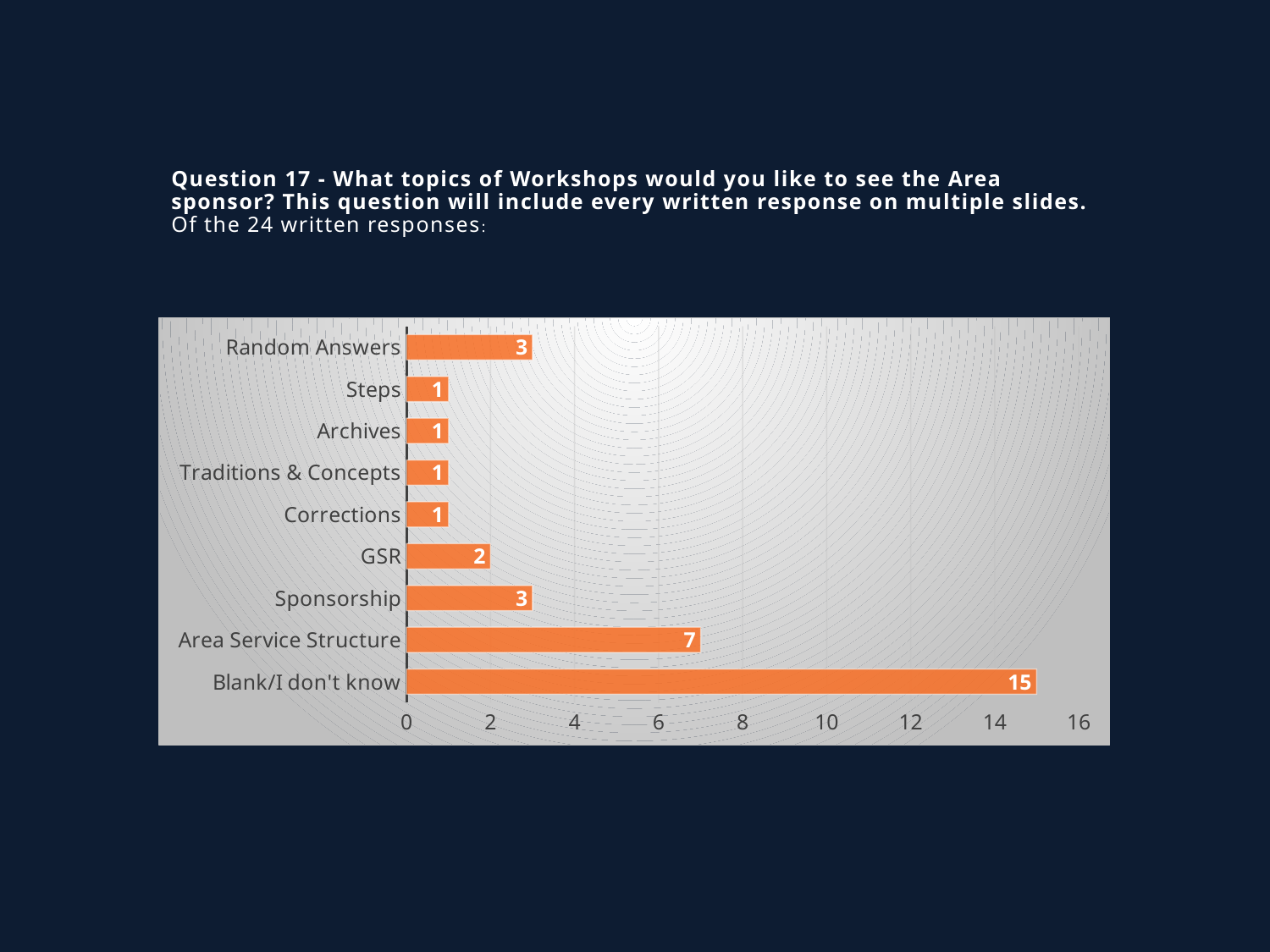
What is the difference between the values for Blank/I don't know and Area Service Structure? 8 Which is larger, the value for Sponsorship or the value for GSR? Sponsorship What is the value for Area Service Structure? 7 What is the value for GSR? 2 How many categories are shown in the chart? 9 Which category has the highest value? Blank/I don't know What is the difference between the values for Sponsorship and Corrections? 2 What is the value for Blank/I don't know? 15 What kind of chart is shown on the slide? bar chart How many categories have a value of 1? 4 Is the value for Area Service Structure greater or less than 6? greater What is the value for Random Answers? 3